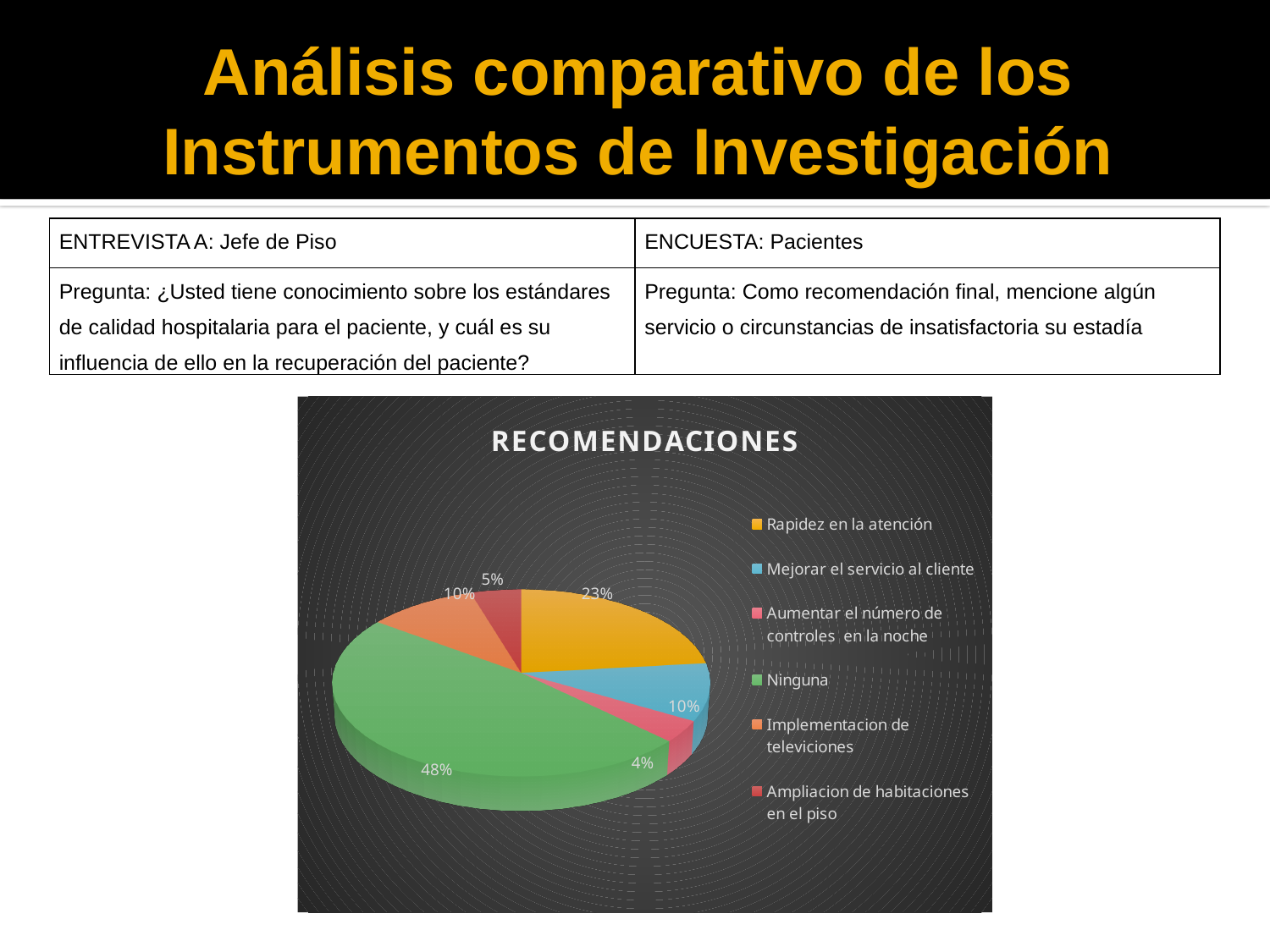
What percentage of the pie corresponds to 'Ninguna'? 48% What type of chart is shown on the slide? pie chart What is the difference in percentage points between 'Ninguna' and 'Rapidez en la atención'? 25 What percentage of the pie corresponds to 'Ampliacion de habitaciones en el piso'? 5% What colour is the slice for 'Ninguna'? green Which category has the largest share of the pie? Ninguna What is the title of the chart? RECOMENDACIONES Which category has the smallest share of the pie? Aumentar el número de controles en la noche How many categories does the legend list? 6 Which is larger: the share for 'Rapidez en la atención' or the share for 'Mejorar el servicio al cliente'? Rapidez en la atención What percentage of the pie corresponds to 'Rapidez en la atención'? 23% What percentage of the pie corresponds to 'Aumentar el número de controles en la noche'? 4%